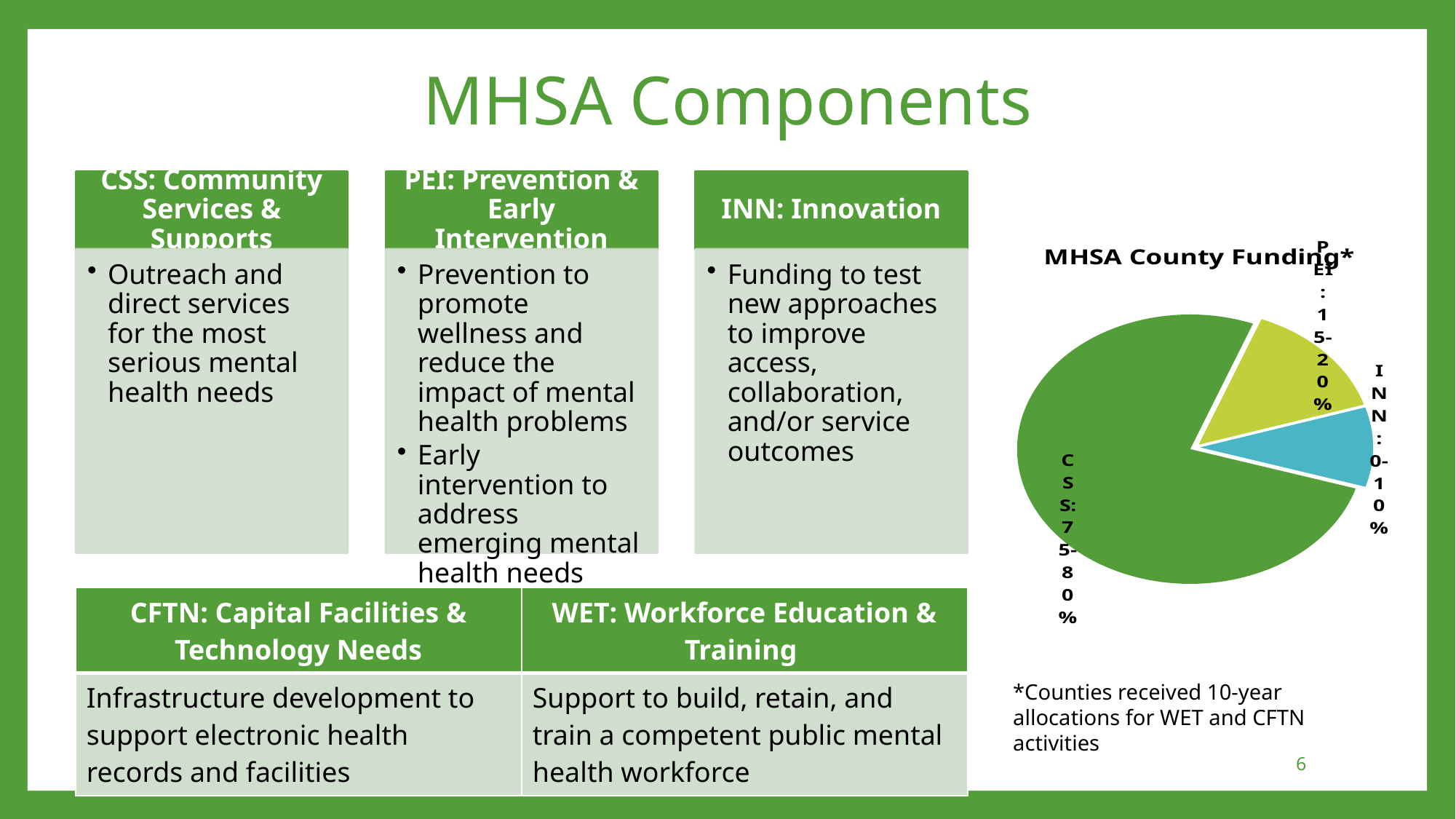
How many slices does the MHSA County Funding* pie chart have? 3 What funding share range is labelled for CSS in the MHSA County Funding* pie chart? 75-80% What is the title of the chart on the slide? MHSA County Funding* What funding share range is labelled for PEI in the MHSA County Funding* pie chart? 15-20% In the MHSA County Funding* pie chart, which slice is larger, CSS or PEI? CSS What type of chart is shown on the slide? pie chart In the MHSA County Funding* pie chart, which slice is larger, PEI or INN? PEI Which component has the smallest slice in the MHSA County Funding* pie chart? INN What colour is the CSS slice in the MHSA County Funding* pie chart? green Which component has the largest slice in the MHSA County Funding* pie chart? CSS What funding share range is labelled for INN in the MHSA County Funding* pie chart? 0-10%